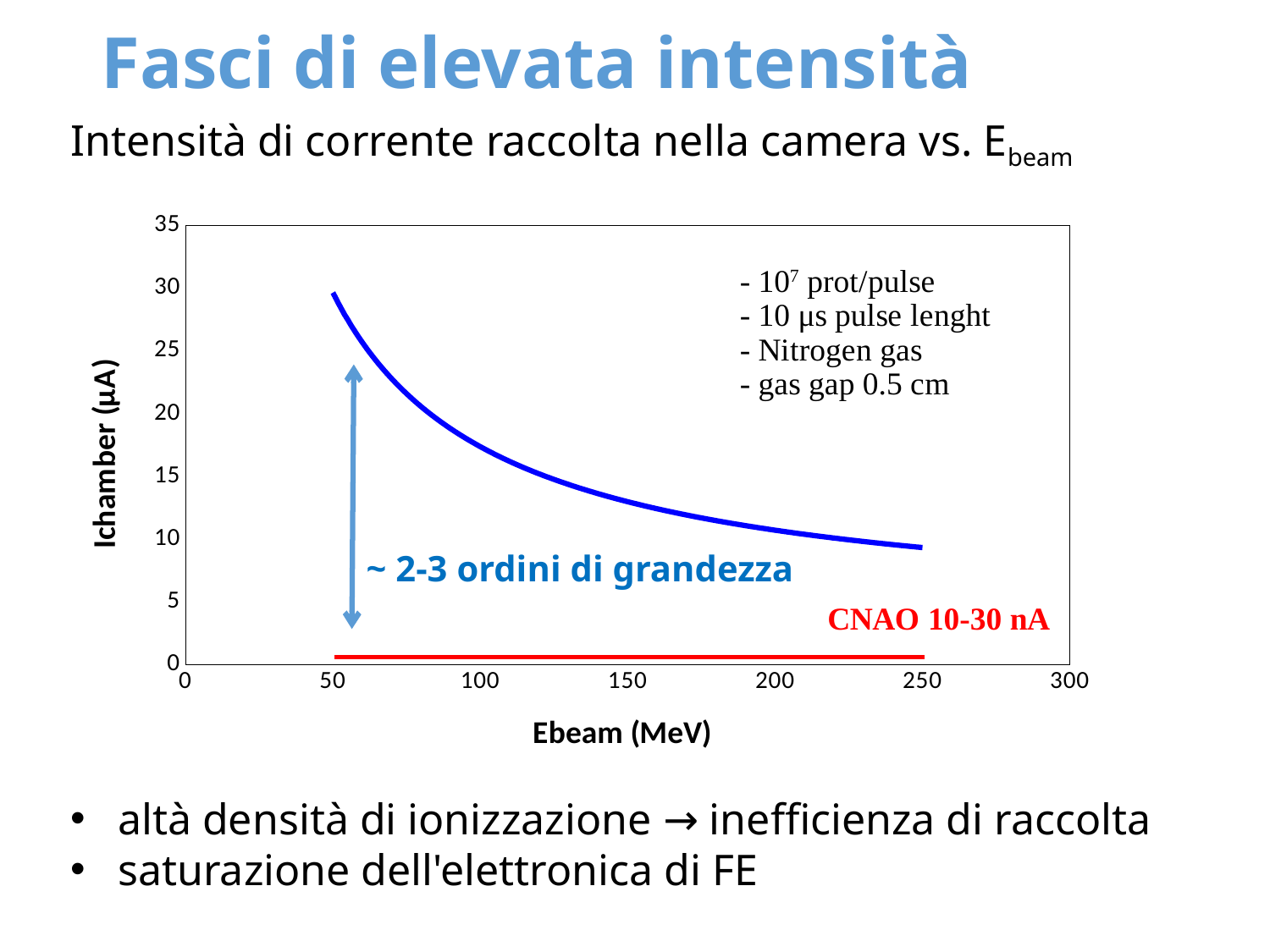
What is the maximum value shown on the x axis of the chart? 300 Is the value of the blue curve at Ebeam = 250 MeV greater or less than 15 μA? less Is the value of the blue curve at Ebeam = 50 MeV greater or less than 25 μA? greater What is the label of the y axis of the chart? Ichamber (μA) Is the value of the blue curve at Ebeam = 200 MeV greater or less than 15 μA? less What current range is given for CNAO in the red annotation on the chart? 10-30 nA Which has the larger Ichamber value on the blue curve: Ebeam = 50 MeV or Ebeam = 250 MeV? 50 MeV How many lines are plotted on the chart? 2 What kind of chart is shown on the slide? line chart What is the label of the x axis of the chart? Ebeam (MeV) Does the blue curve rise or fall as Ebeam increases from 50 to 250 MeV? fall